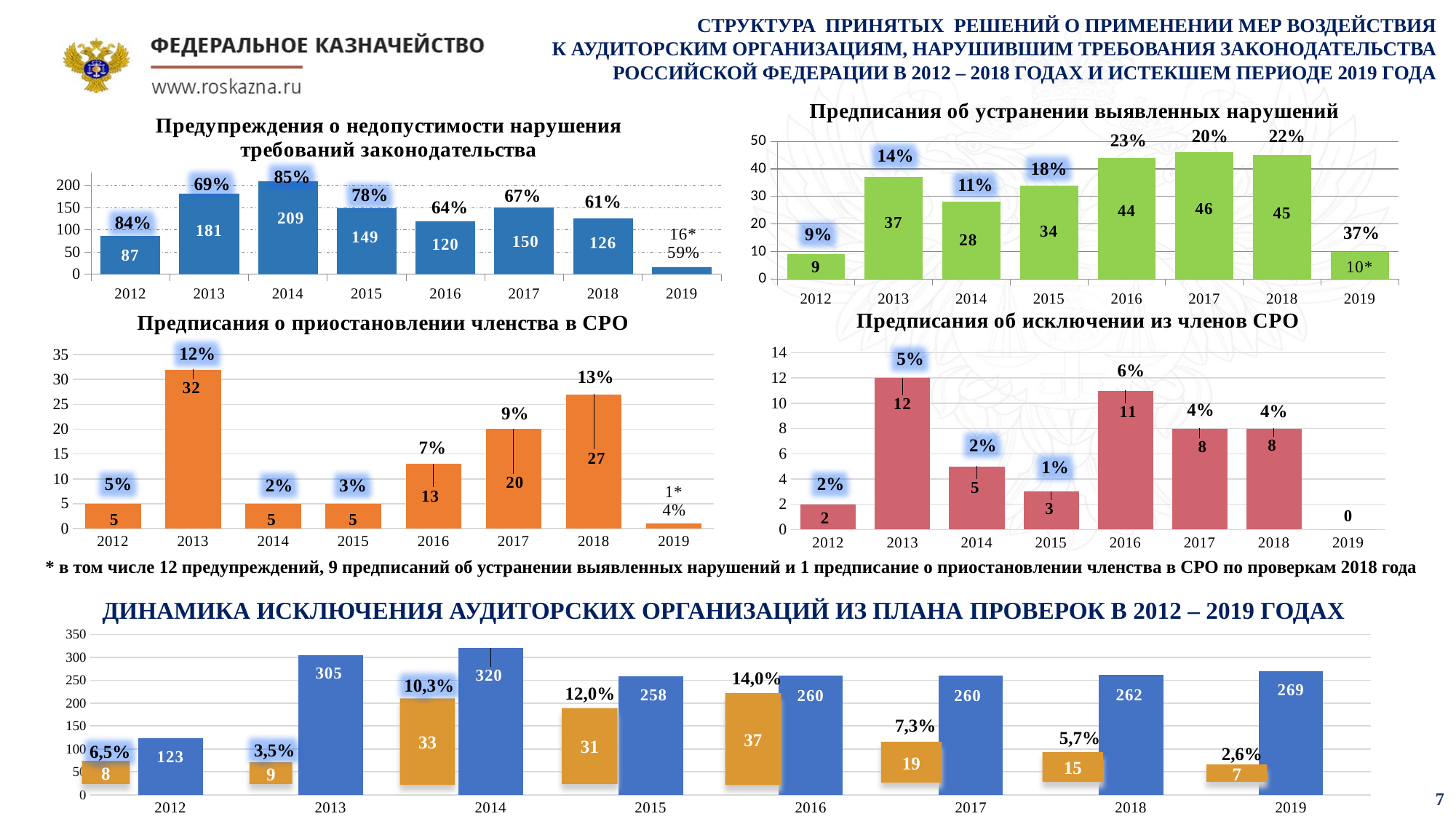
In the chart 'Предупреждения о недопустимости нарушения требований законодательства', which year has the highest value? 2014 In the bottom chart 'ДИНАМИКА ИСКЛЮЧЕНИЯ АУДИТОРСКИХ ОРГАНИЗАЦИЙ ИЗ ПЛАНА ПРОВЕРОК В 2012 – 2019 ГОДАХ', what percentage is shown for 2016? 14,0% In the chart 'Предписания о приостановлении членства в СРО', what is the value for 2013? 32 What kind of chart is 'Предписания об исключении из членов СРО'? Bar chart In the chart 'Предписания об устранении выявленных нарушений', what is the value for 2017? 46 In the chart 'Предписания об исключении из членов СРО', what percentage is shown above the 2013 bar? 5% In the chart 'Предписания об устранении выявленных нарушений', which year has the lowest value? 2012 In the chart 'Предписания об устранении выявленных нарушений', what is the difference between the values for 2016 and 2014? 16 In the chart 'Предупреждения о недопустимости нарушения требований законодательства', what is the value for 2014? 209 In the chart 'Предписания о приостановлении членства в СРО', which is larger, the value for 2017 or the value for 2018? 2018 In the bottom chart 'ДИНАМИКА ИСКЛЮЧЕНИЯ АУДИТОРСКИХ ОРГАНИЗАЦИЙ ИЗ ПЛАНА ПРОВЕРОК В 2012 – 2019 ГОДАХ', what is the value of the blue bar for 2014? 320 In the chart 'Предписания об исключении из членов СРО', what is the value for 2016? 11